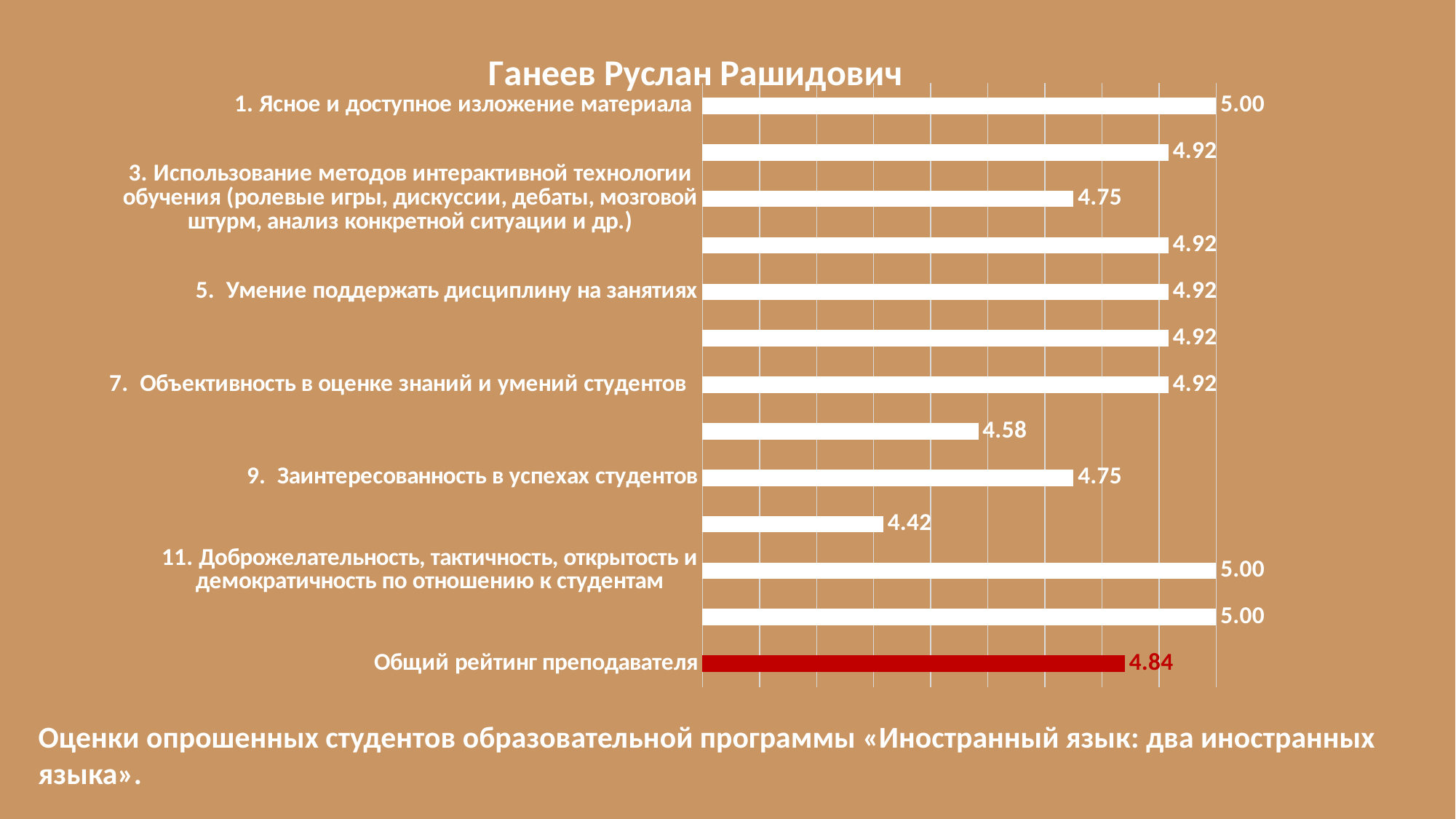
What is the value for "Общий рейтинг преподавателя"? 4.84 What is the value for "11. Доброжелательность, тактичность, открытость и демократичность по отношению к студентам"? 5.00 What is the difference between the value for "1. Ясное и доступное изложение материала" and the value for "9. Заинтересованность в успехах студентов"? 0.25 What is the value for "5. Умение поддержать дисциплину на занятиях"? 4.92 Which has the larger value: "3. Использование методов интерактивной технологии обучения" or "7. Объективность в оценке знаний и умений студентов"? 7. Объективность в оценке знаний и умений студентов What is the lowest value shown on the chart? 4.42 What kind of chart is shown on the slide? Bar chart What is the value for "1. Ясное и доступное изложение материала"? 5.00 What colour is the bar for "Общий рейтинг преподавателя"? Red How many bars are plotted on the chart? 13 What is the value for "9. Заинтересованность в успехах студентов"? 4.75 What is the title of the chart? Ганеев Руслан Рашидович